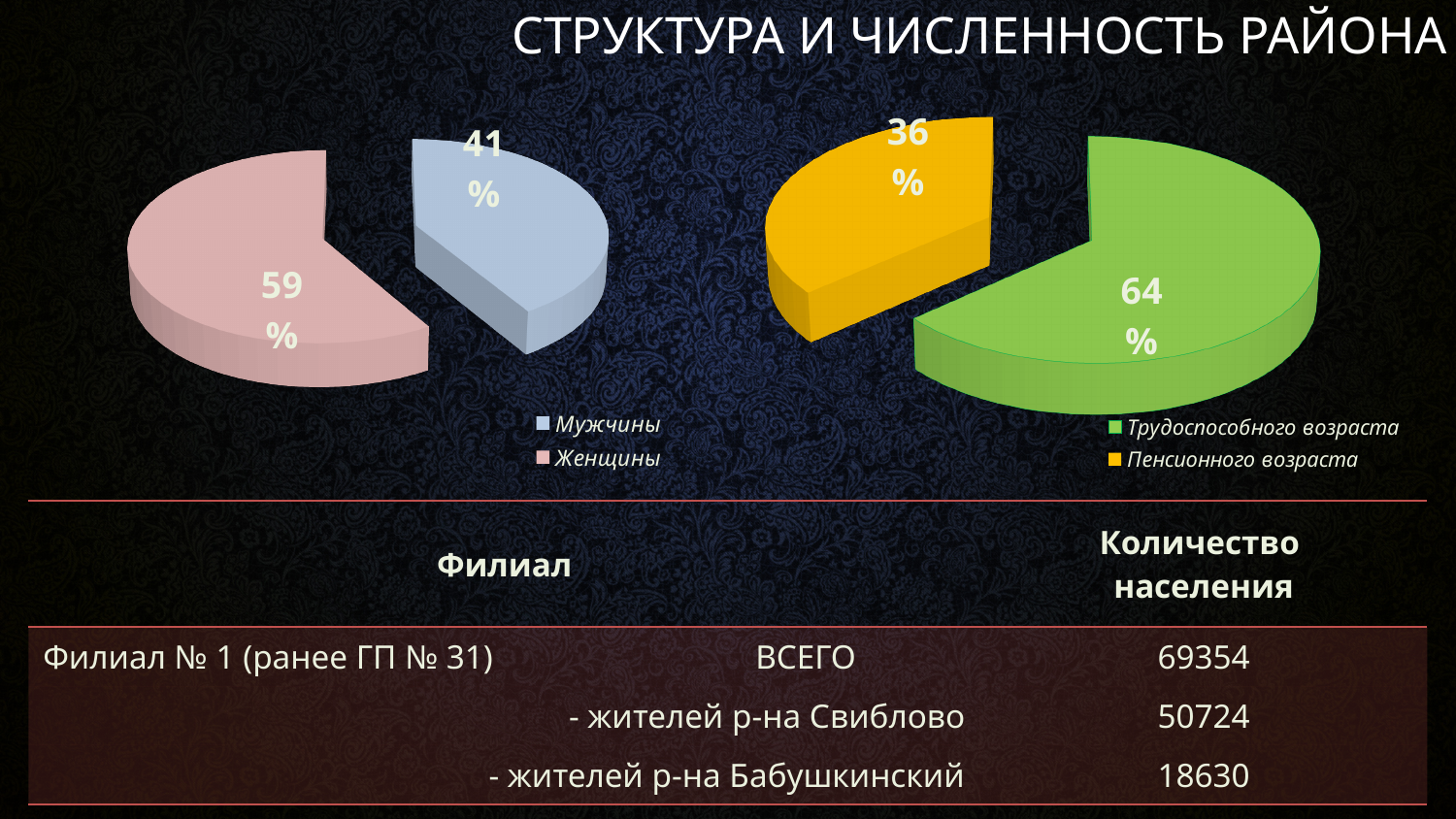
What colour is the Трудоспособного возраста slice on the right pie chart? Green How many slices does the right pie chart have? 2 On the left pie chart, which category has the larger slice? Женщины On the right pie chart, what share is shown for Пенсионного возраста? 36% On the left pie chart, what share is shown for Мужчины? 41% On the left pie chart, what share is shown for Женщины? 59% What type of chart is the left chart on the slide? Pie chart On the right pie chart, what share is shown for Трудоспособного возраста? 64% On the right pie chart, which category has the smaller slice? Пенсионного возраста Which is larger: the Мужчины slice on the left pie chart or the Пенсионного возраста slice on the right pie chart? Мужчины On the left pie chart, what is the difference in percentage points between Женщины and Мужчины? 18 On the right pie chart, what is the difference in percentage points between Трудоспособного возраста and Пенсионного возраста? 28